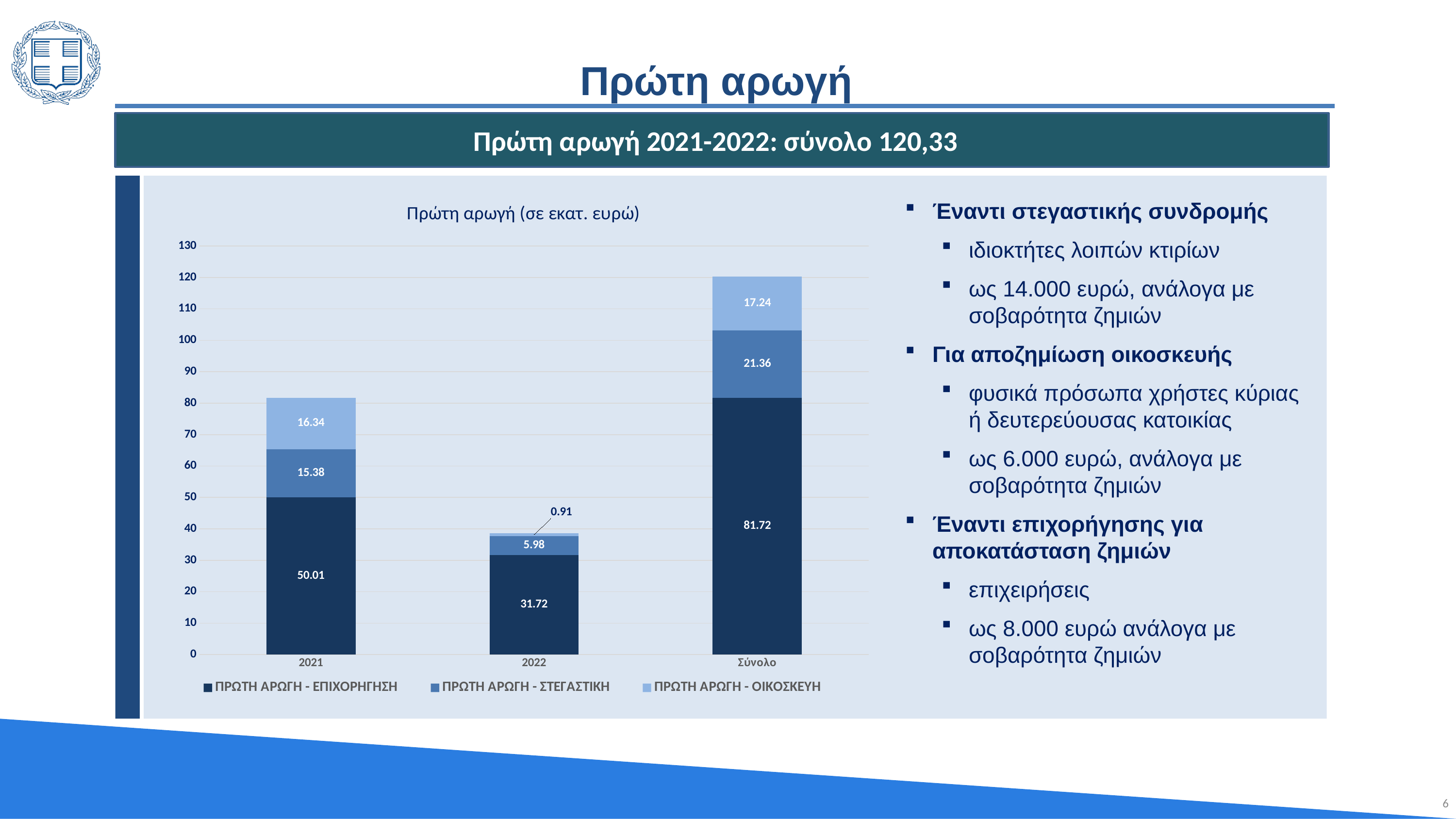
Which is larger for 2021: ΠΡΩΤΗ ΑΡΩΓΗ - ΣΤΕΓΑΣΤΙΚΗ or ΠΡΩΤΗ ΑΡΩΓΗ - ΟΙΚΟΣΚΕΥΗ? ΠΡΩΤΗ ΑΡΩΓΗ - ΟΙΚΟΣΚΕΥΗ What is the value of ΠΡΩΤΗ ΑΡΩΓΗ - ΟΙΚΟΣΚΕΥΗ for Σύνολο? 17.24 Which category has the lowest ΠΡΩΤΗ ΑΡΩΓΗ - ΕΠΙΧΟΡΗΓΗΣΗ value? 2022 What is the total of the stacked bar for 2022? 38.61 What kind of chart is shown on the slide? Stacked bar chart What is the total of the stacked bar for 2021? 81.73 What is the value of ΠΡΩΤΗ ΑΡΩΓΗ - ΕΠΙΧΟΡΗΓΗΣΗ for 2021? 50.01 How many categories are shown on the x axis? 3 How many series does the legend list? 3 What is the value of ΠΡΩΤΗ ΑΡΩΓΗ - ΣΤΕΓΑΣΤΙΚΗ for 2022? 5.98 What is the value of ΠΡΩΤΗ ΑΡΩΓΗ - ΟΙΚΟΣΚΕΥΗ for 2022? 0.91 What is the difference between ΠΡΩΤΗ ΑΡΩΓΗ - ΕΠΙΧΟΡΗΓΗΣΗ in 2021 and in 2022? 18.29